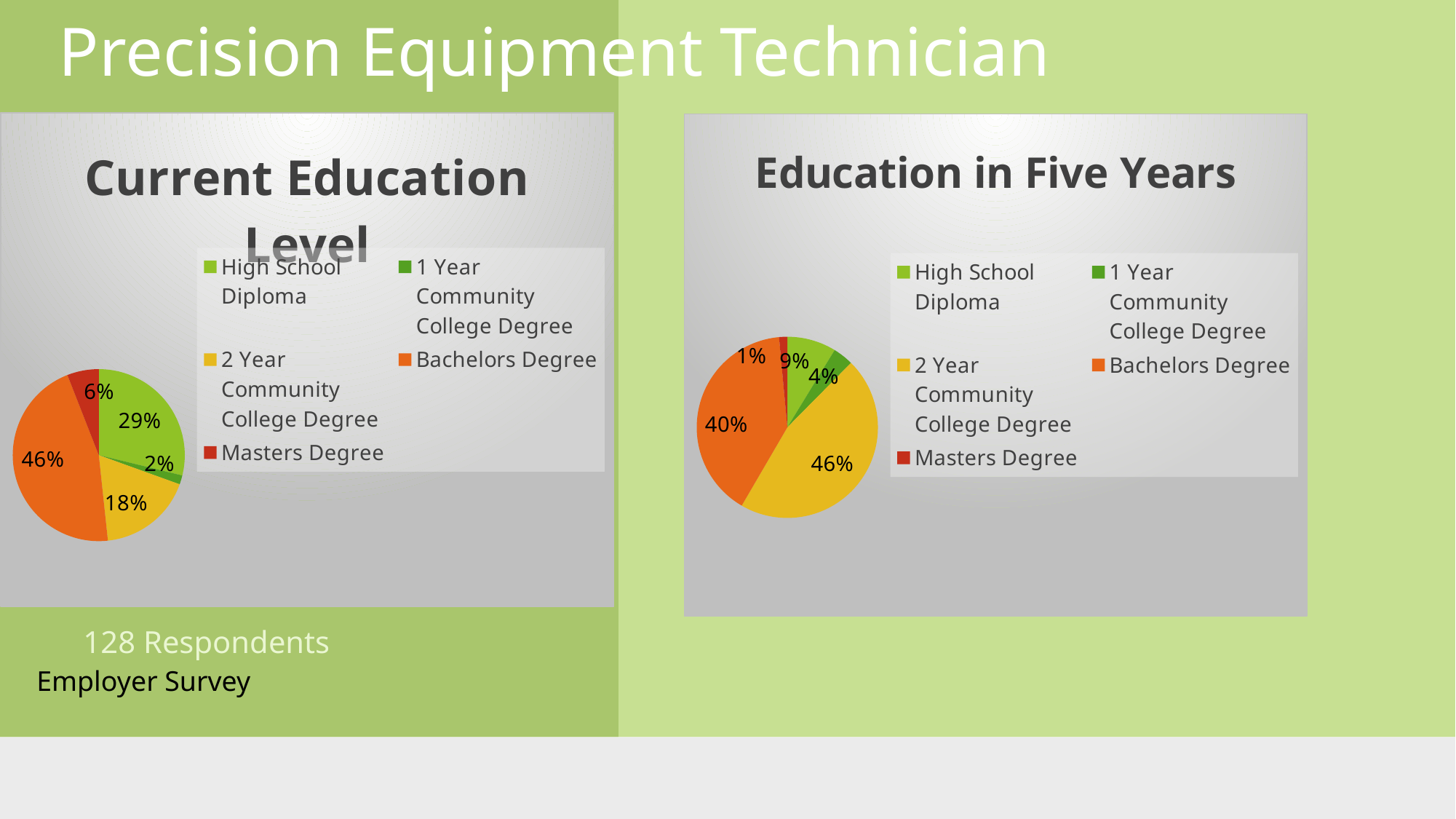
In the Current Education Level chart, which category has the smallest slice? 1 Year Community College Degree In the Education in Five Years chart, what percentage is shown for Masters Degree? 1% In the Education in Five Years chart, which category has the largest slice? 2 Year Community College Degree In the Current Education Level chart, what share of respondents is shown for Bachelors Degree? 46% In the Education in Five Years chart, which is larger: High School Diploma or 1 Year Community College Degree? High School Diploma In the Current Education Level chart, what percentage is shown for High School Diploma? 29% In the Current Education Level chart, what is the difference between the Bachelors Degree and 2 Year Community College Degree percentages? 28% In the Education in Five Years chart, what percentage is shown for 2 Year Community College Degree? 46% How many categories does the legend of the Education in Five Years chart list? 5 What type of chart is the Current Education Level chart? Pie chart In the Education in Five Years chart, what colour represents Bachelors Degree? Orange In the Current Education Level chart, which category has the largest slice? Bachelors Degree